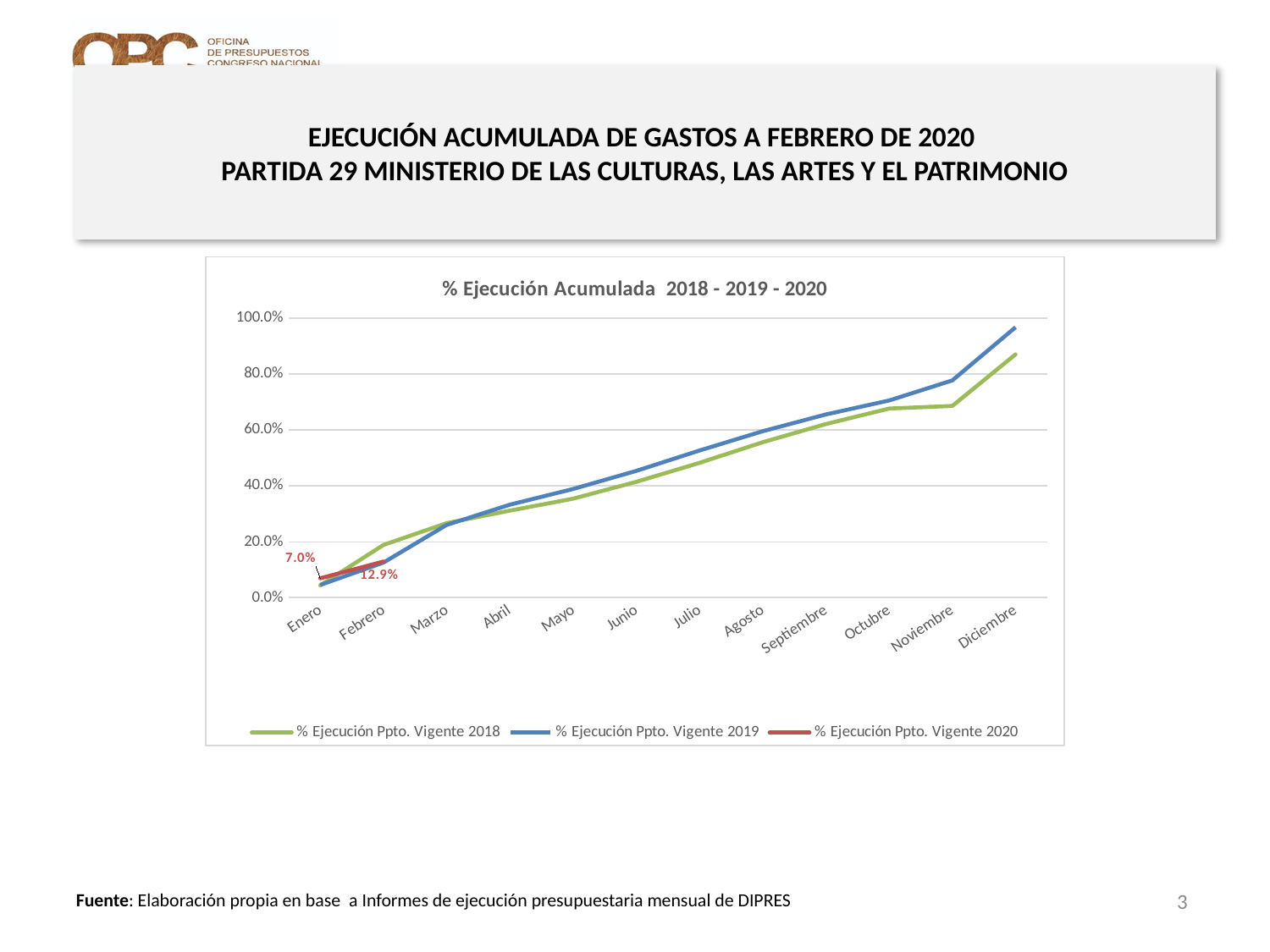
Do the values of the % Ejecución Ppto. Vigente 2019 series rise or fall from Enero to Diciembre? rise What is the title of the chart? % Ejecución Acumulada 2018 - 2019 - 2020 Which month has the highest value in the % Ejecución Ppto. Vigente 2018 series? Diciembre What is the value for Enero in the % Ejecución Ppto. Vigente 2020 series? 7.0% How many series does the legend list? 3 By how much did the % Ejecución Ppto. Vigente 2020 series increase from Enero to Febrero? 5.9% In Diciembre, which series has the larger value: % Ejecución Ppto. Vigente 2018 or % Ejecución Ppto. Vigente 2019? % Ejecución Ppto. Vigente 2019 How many months are shown along the x axis? 12 What is the value for Febrero in the % Ejecución Ppto. Vigente 2020 series? 12.9% Is the value for Diciembre in the % Ejecución Ppto. Vigente 2019 series greater or less than 80.0%? greater Is the value for Noviembre in the % Ejecución Ppto. Vigente 2019 series greater or less than 80.0%? less What kind of chart is shown on the slide? line chart